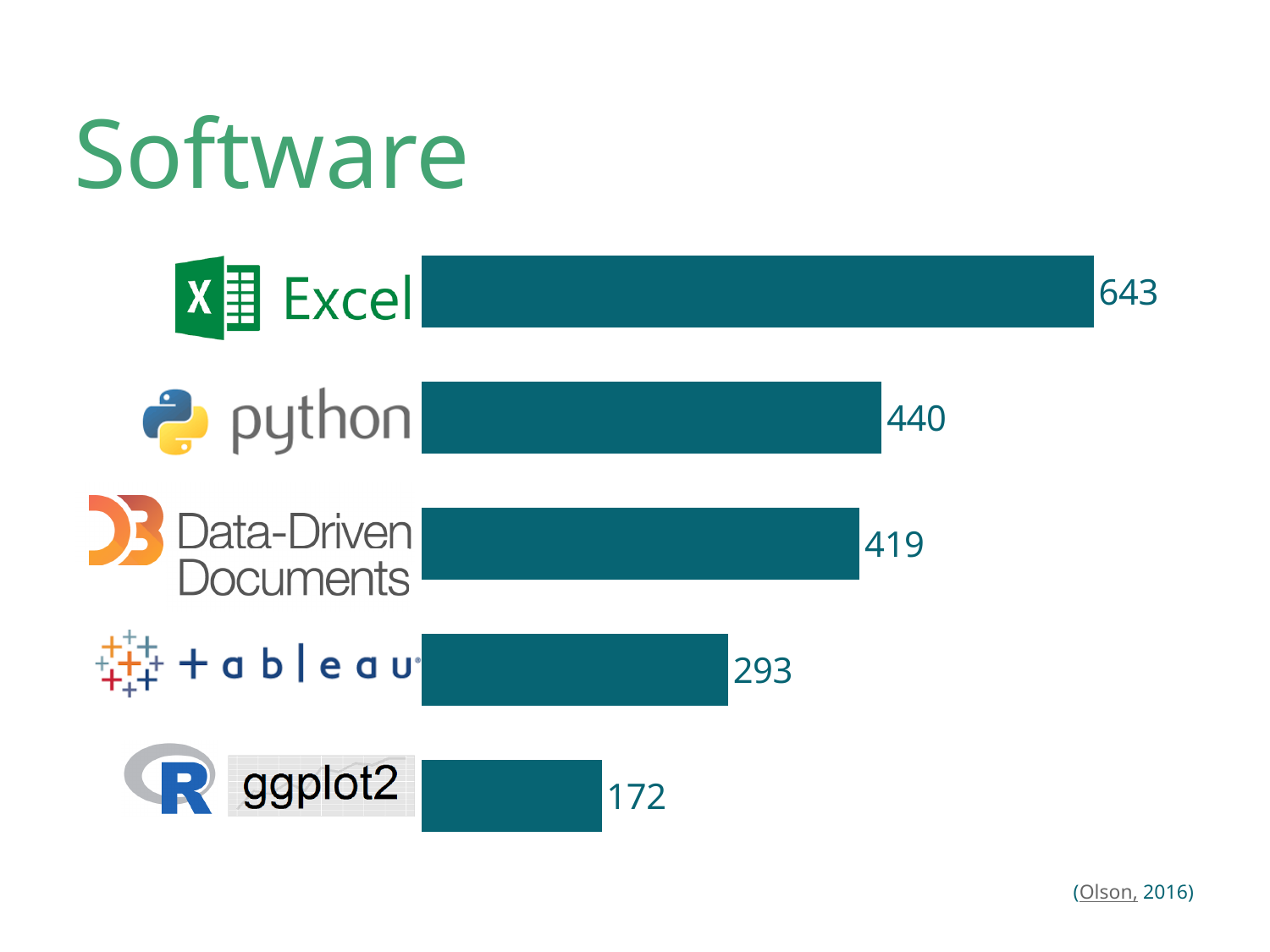
What is the value for D3 Data-Driven Documents? 419 How many software categories are shown in the chart? 5 What is the value for Excel? 643 Which has a larger value, python or D3 Data-Driven Documents? python What is the value for ggplot2? 172 What is the difference between the values for Excel and python? 203 Which software has the highest value? Excel What is the value for tableau? 293 What kind of chart is shown on the slide? bar chart Which software has the lowest value? ggplot2 What is the difference between the values for tableau and ggplot2? 121 What is the value for python? 440